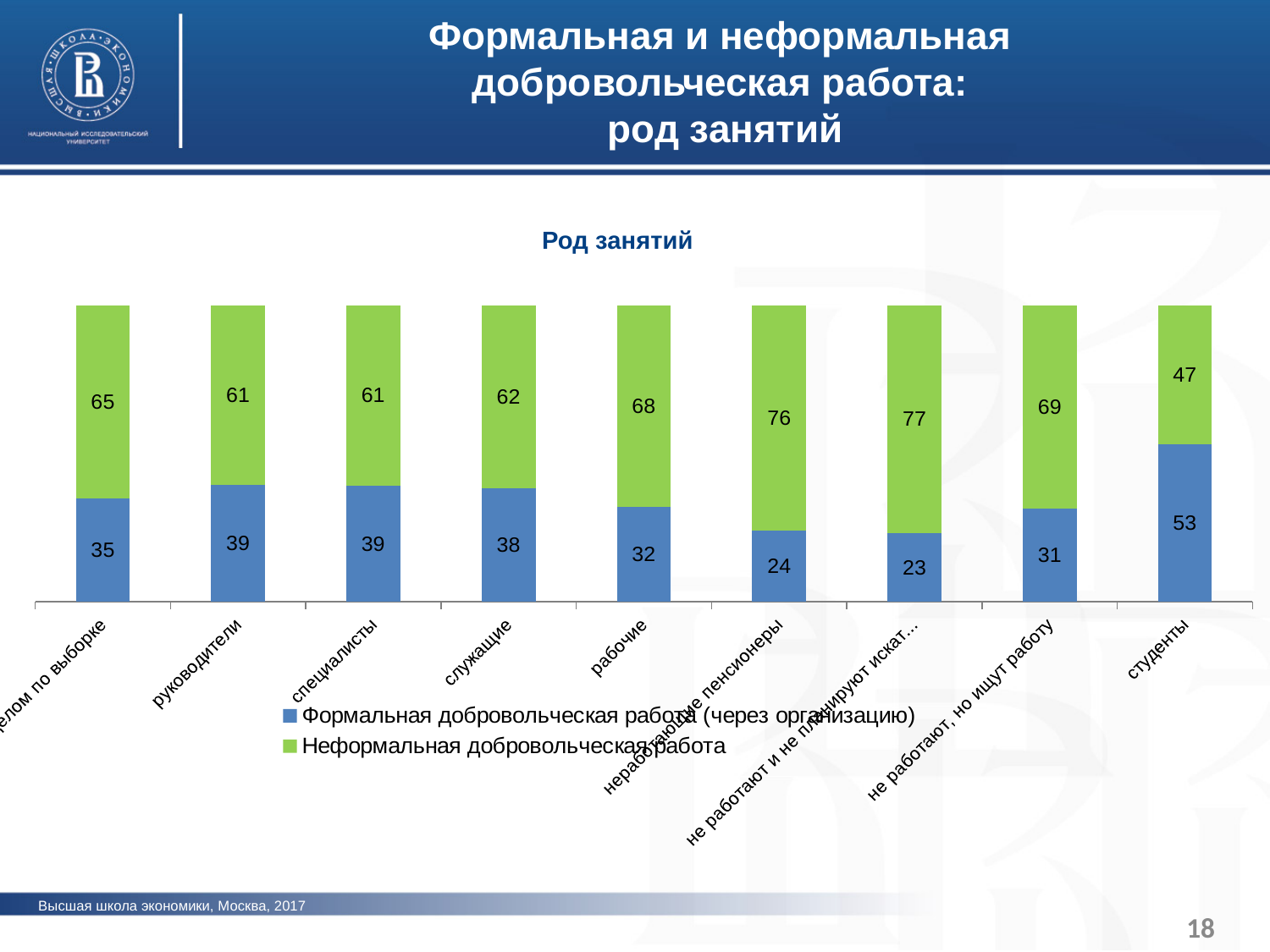
How many categories are shown on the x axis? 9 What kind of chart is shown on the slide? stacked bar chart Which category has the lowest value for Неформальная добровольческая работа? студенты What is the value of Неформальная добровольческая работа for рабочие? 68 Which is larger: the Формальная добровольческая работа value for руководители or for рабочие? руководители Which category has the highest value for Формальная добровольческая работа (через организацию)? студенты What is the value of Неформальная добровольческая работа for неработающие пенсионеры? 76 How many series does the legend list? 2 What is the value of Формальная добровольческая работа (через организацию) for служащие? 38 What is the total of the stacked bar for студенты? 100 What is the difference between the Неформальная добровольческая работа values for неработающие пенсионеры and руководители? 15 What is the value of Формальная добровольческая работа (через организацию) for студенты? 53